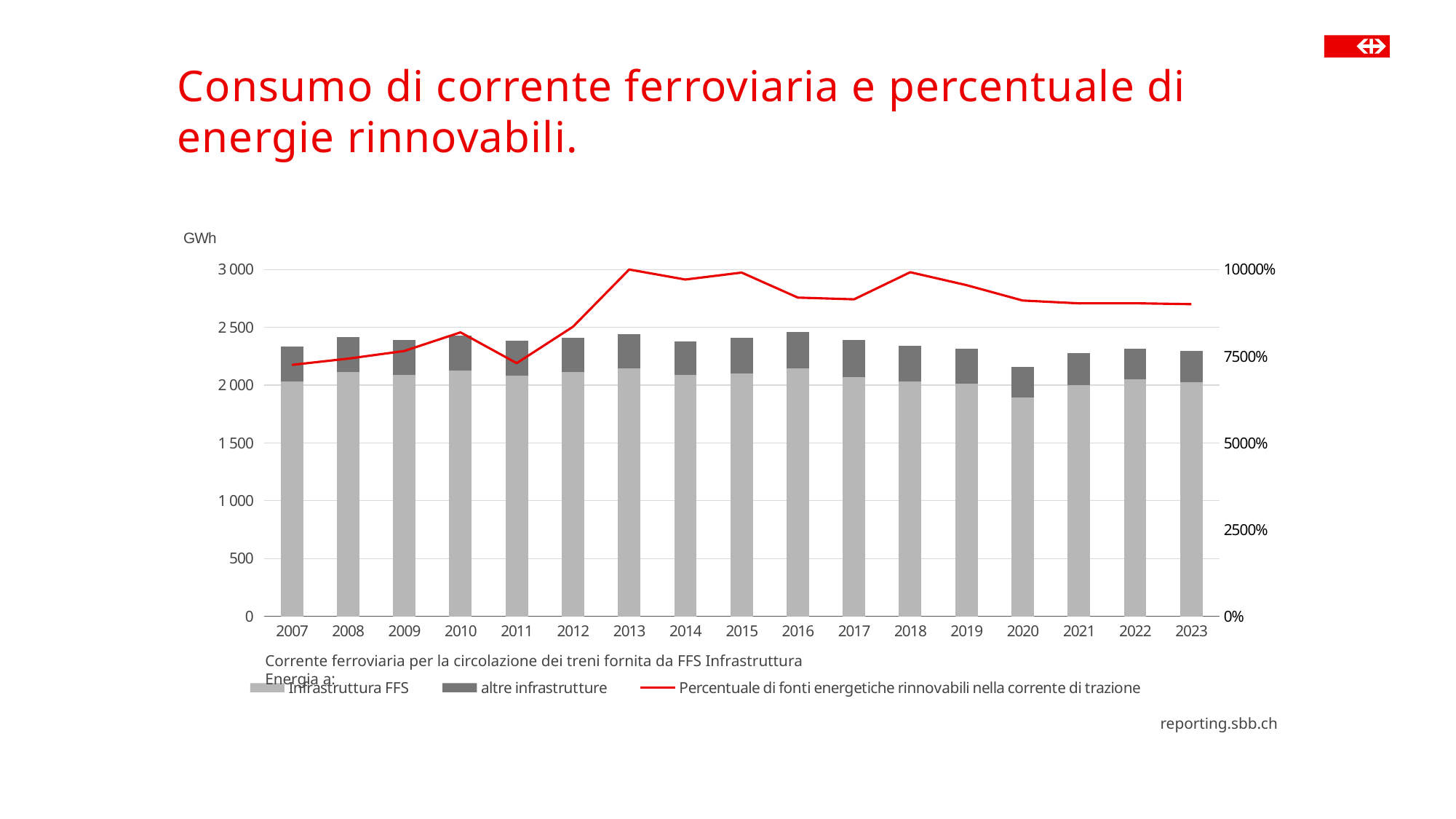
Which year has the larger total bar, 2016 or 2020? 2016 What colour is the line for 'Percentuale di fonti energetiche rinnovabili nella corrente di trazione'? Red Is the percentage of renewable energy sources in 2013 greater or less than 7500%? greater Is the total bar for 2020 greater or less than 2 500 GWh? less How many series does the chart legend list? 3 What unit is shown on the left vertical axis? GWh Is the Infrastruttura FFS value for 2020 greater or less than 2 000 GWh? less Which year has the lowest total bar (total rail current consumption)? 2020 Does the red line (percentage of renewable energy sources) rise or fall between 2011 and 2013? rise How many years are shown on the x axis of the chart? 17 What kind of chart is shown on the slide? A stacked bar chart combined with a line chart